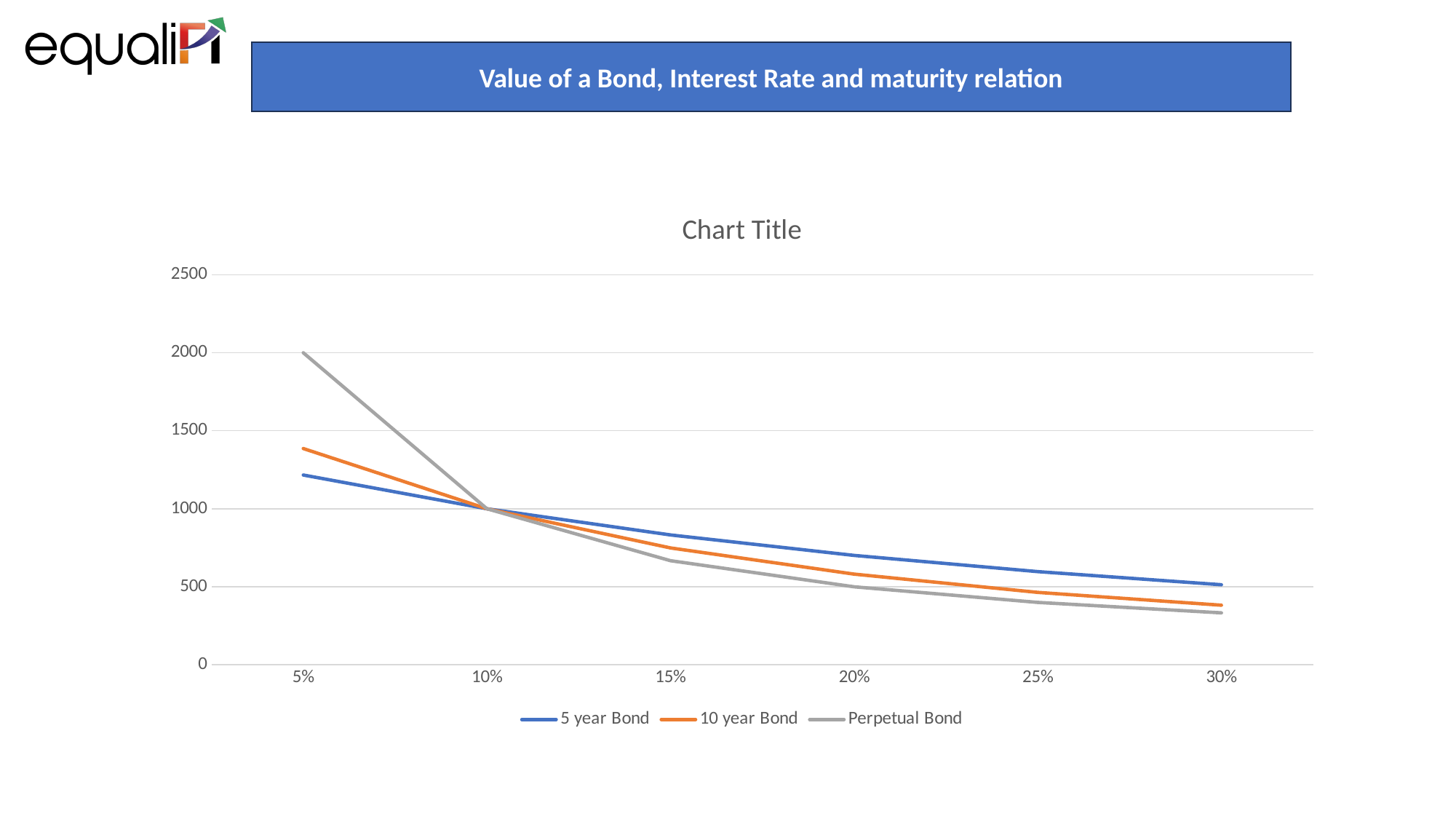
How many series does the chart legend list? 3 Which series has the highest value at 20%? 5 year Bond What is the value of the 5 year Bond at 10%? 1000 Which series has the highest value at 5%? Perpetual Bond What is the title shown in the blue banner at the top of the slide? Value of a Bond, Interest Rate and maturity relation What type of chart is shown on the slide? line chart Do the values of the 5 year Bond rise or fall as the interest rate increases along the x axis? fall Is the value for the 10 year Bond at 5% greater or less than 1000? greater How many interest rate points are shown along the x axis? 6 Is the value for the Perpetual Bond at 20% greater or less than 1000? less Which series has the lowest value at 30%? Perpetual Bond What is the value of the Perpetual Bond at 5%? 2000